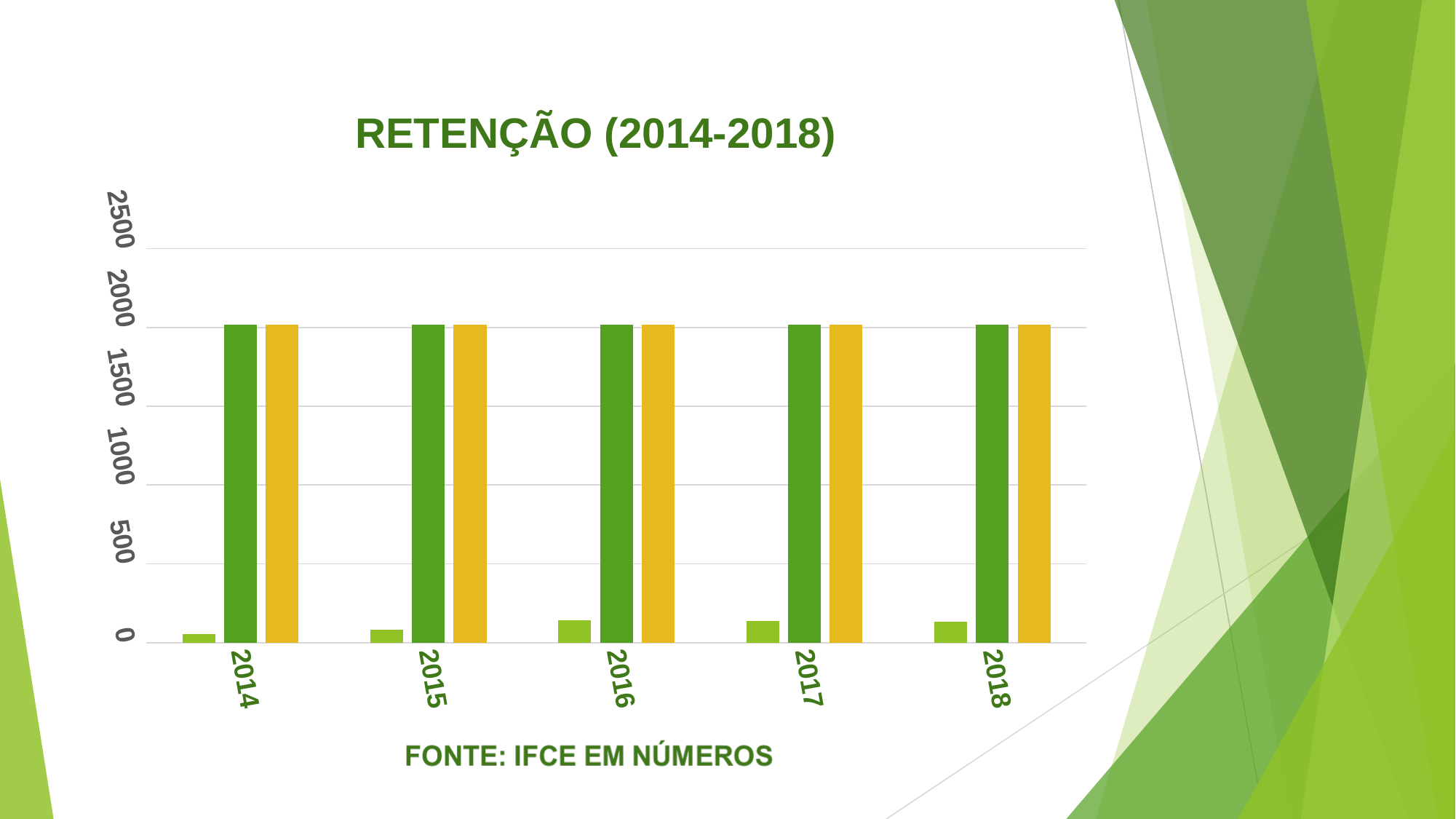
Is the value of the dark green bar for 2014 greater or less than 1500? greater In 2014, which is taller: the light green bar or the dark green bar? the dark green bar Is the value of the yellow bar for 2018 greater or less than 2500? less What is the title of the chart? RETENÇÃO (2014-2018) Is the value of the light green bar for 2016 greater or less than 500? less How many years are shown on the x axis of the chart? 5 Is the light green bar for 2016 taller or shorter than the light green bar for 2014? taller Which year has the shortest light green bar? 2014 What kind of chart is shown on the slide? bar chart What source is cited below the chart? IFCE EM NÚMEROS How many bars are plotted for each year in the chart? 3